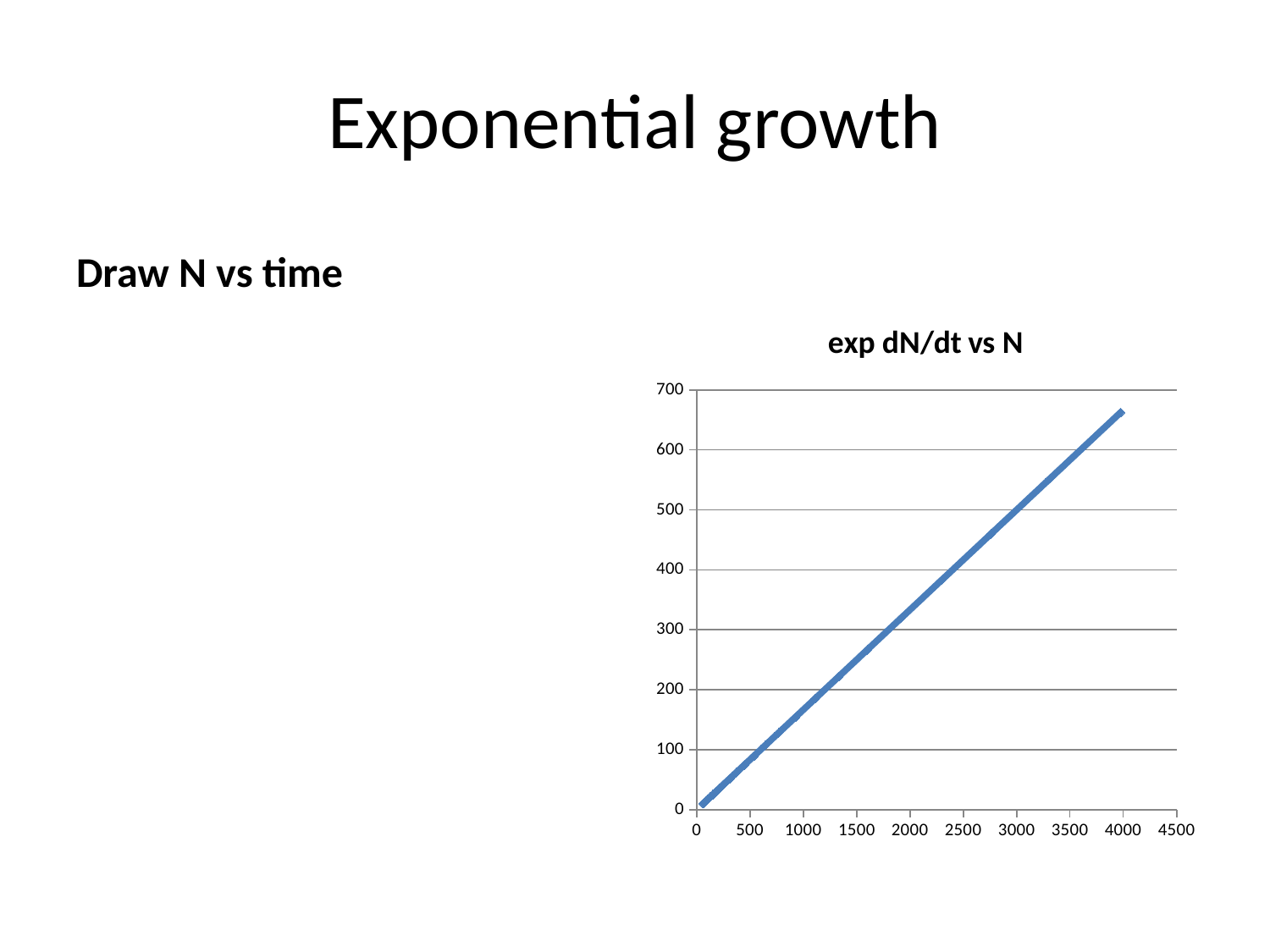
Is the value for N = 1000 greater or less than 200? less Is the value for N = 4000 greater or less than 700? less What is the title of the chart on the slide? exp dN/dt vs N Is the value for N = 2000 greater or less than 300? greater What is the highest tick label shown on the y axis of the chart? 700 Do the plotted values rise or fall as N increases along the x axis? rise Is the value at N = 4000 larger or smaller than the value at N = 1000? larger